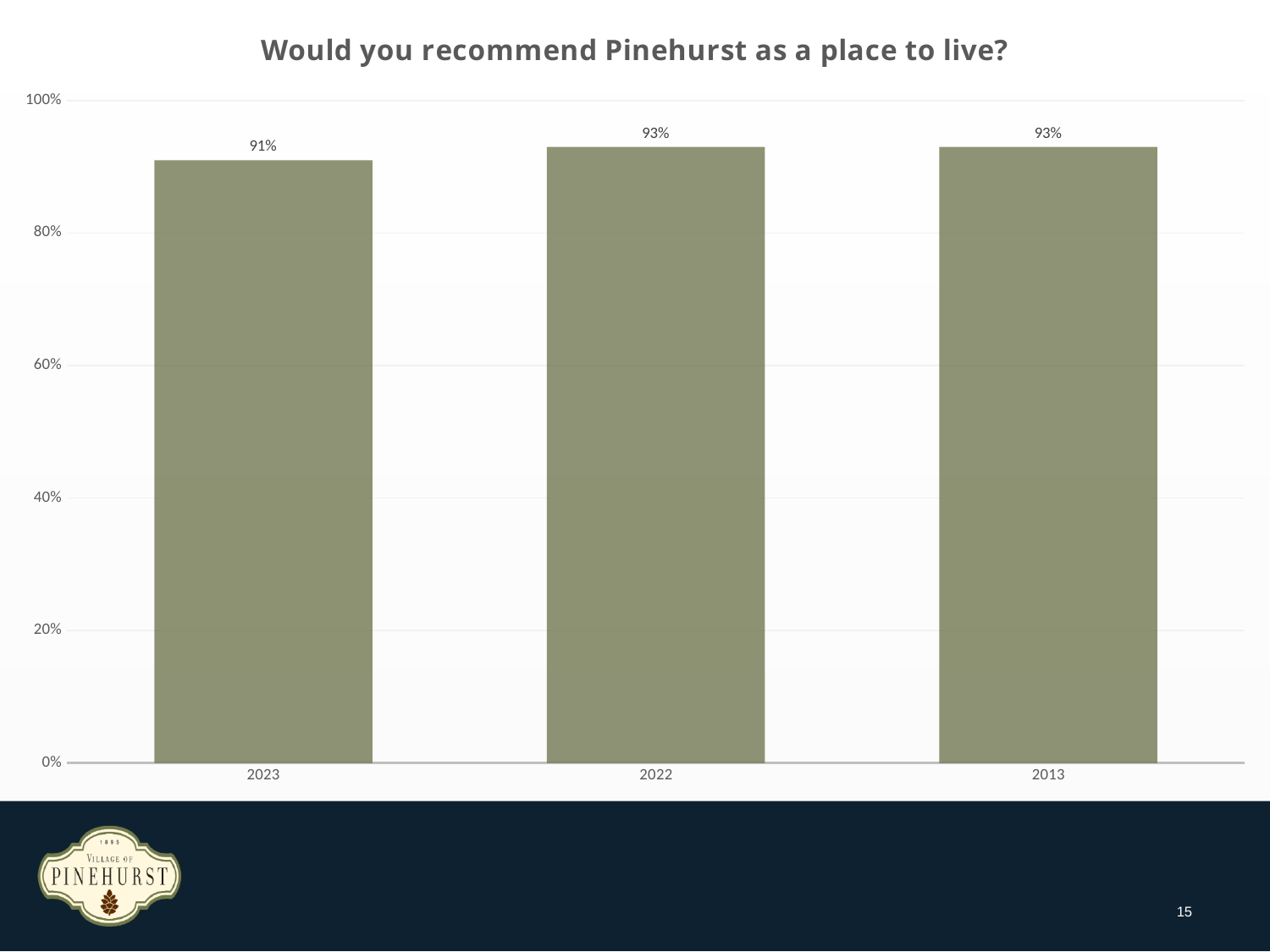
Do the values for 2022 and 2013 differ? No How many years are shown on the x axis? 3 Is the value for 2023 greater or less than 80%? greater What is the highest value shown on the y axis? 100% What is the value for 2013? 93% Which year has the lowest value? 2023 What is the value for 2023? 91% Which is larger, the value for 2023 or the value for 2022? 2022 What is the value for 2022? 93% What is the difference between the values for 2022 and 2023? 2% What is the title of the chart? Would you recommend Pinehurst as a place to live? What kind of chart is this? bar chart